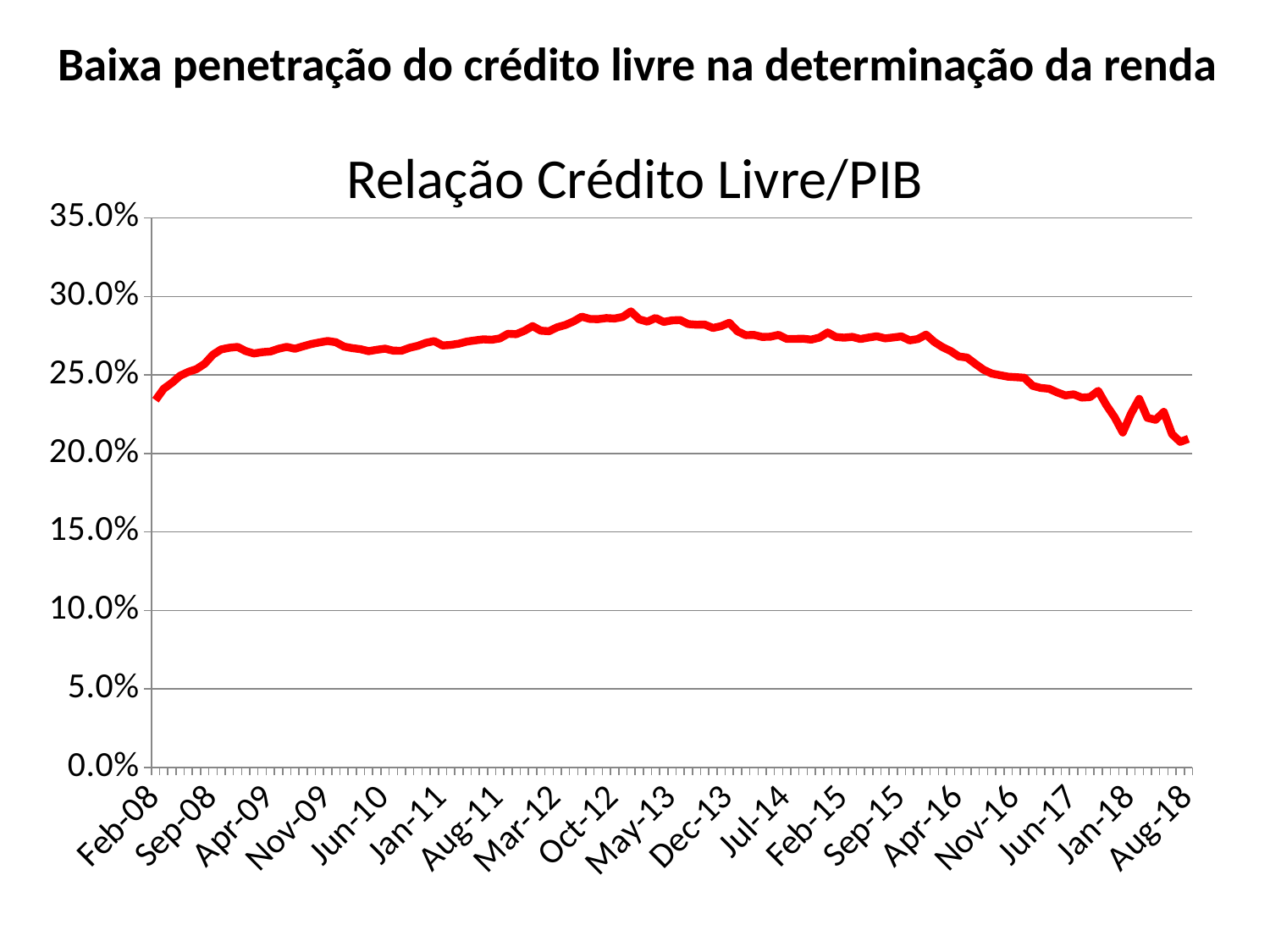
What is the title of the chart? Relação Crédito Livre/PIB Does the value rise or fall between Apr-16 and Aug-18? fall Is the value for Feb-08 greater or less than 25.0%? less Is the value for Apr-16 greater or less than 25.0%? greater Does the value rise or fall between Feb-08 and Oct-12? rise Which is larger, the value for Oct-12 or the value for Aug-18? Oct-12 Is the value for Oct-12 greater or less than 25.0%? greater What kind of chart is shown on the slide? line chart What is the highest value shown on the vertical axis? 35.0%